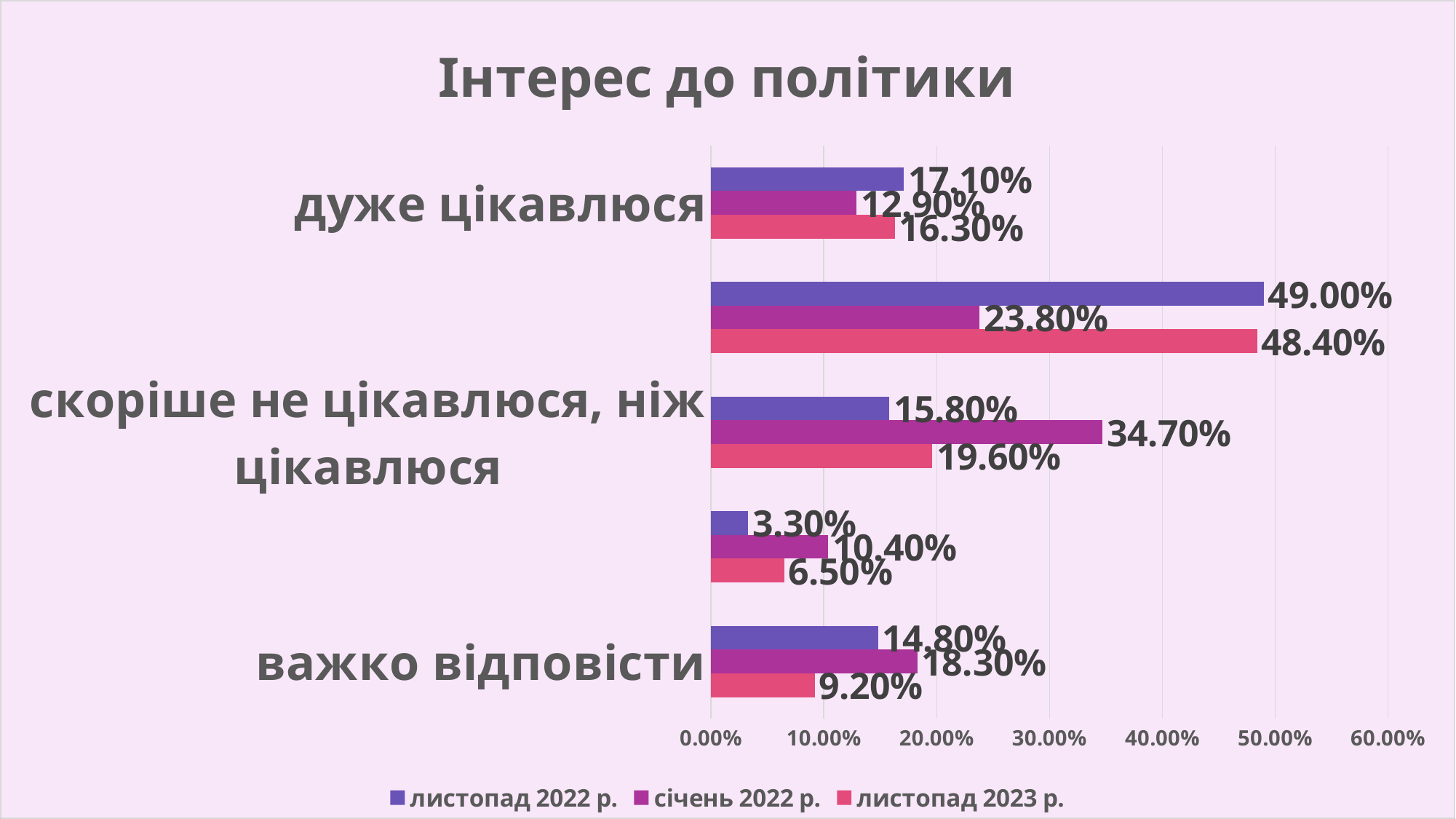
Which series has the lowest value for "дуже цікавлюся"? січень 2022 р. Is the "січень 2022 р." value for "скоріше не цікавлюся, ніж цікавлюся" greater or less than 30.00%? greater Which series has the highest value for "скоріше не цікавлюся, ніж цікавлюся"? січень 2022 р. For "дуже цікавлюся", which is larger: the "листопад 2022 р." value or the "листопад 2023 р." value? листопад 2022 р. What is the value for "скоріше не цікавлюся, ніж цікавлюся" in the "січень 2022 р." series? 34.70% What is the value for "дуже цікавлюся" in the "листопад 2022 р." series? 17.10% What is the difference between the "листопад 2022 р." and "листопад 2023 р." values for "важко відповісти"? 5.60% What kind of chart is shown on the slide? bar chart What is the value for "важко відповісти" in the "січень 2022 р." series? 18.30% What is the value for "важко відповісти" in the "листопад 2023 р." series? 9.20% How many series does the legend list? 3 What is the title of the chart? Інтерес до політики